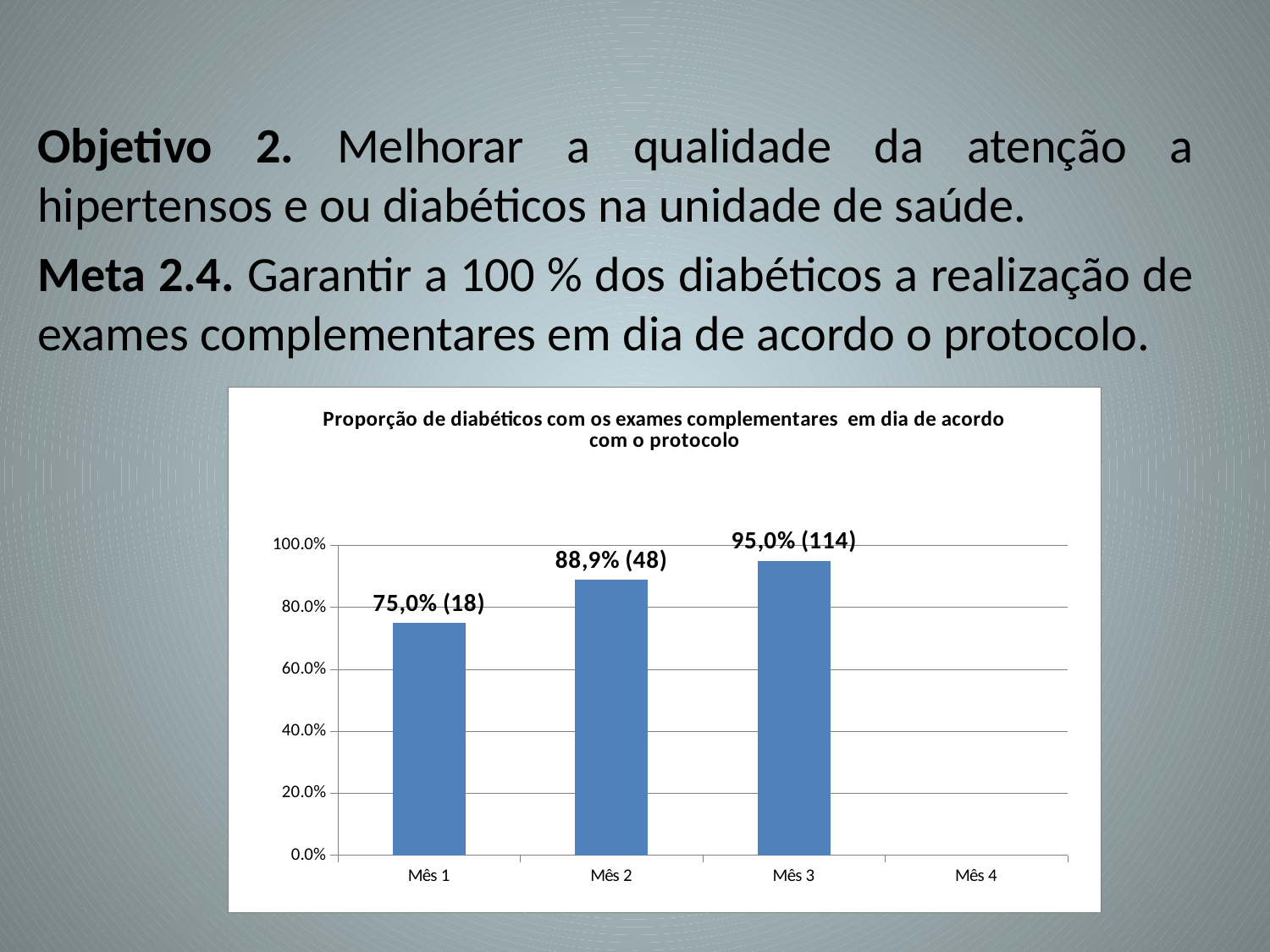
How many diabetics are shown in parentheses for Mês 3? 114 Is the value for Mês 1 greater or less than 80.0%? less What is the data label shown for Mês 1? 75,0% (18) What is the data label shown for Mês 2? 88,9% (48) What percentage is shown for Mês 3? 95,0% What is the difference between the counts in parentheses for Mês 3 and Mês 1? 96 Do the values rise or fall from Mês 1 to Mês 3? rise What kind of chart is shown on the slide? bar chart Which is larger, the proportion for Mês 2 or for Mês 3? Mês 3 How many bars are plotted in the chart? 3 Which month has the highest proportion? Mês 3 Which month with a plotted bar has the lowest proportion? Mês 1